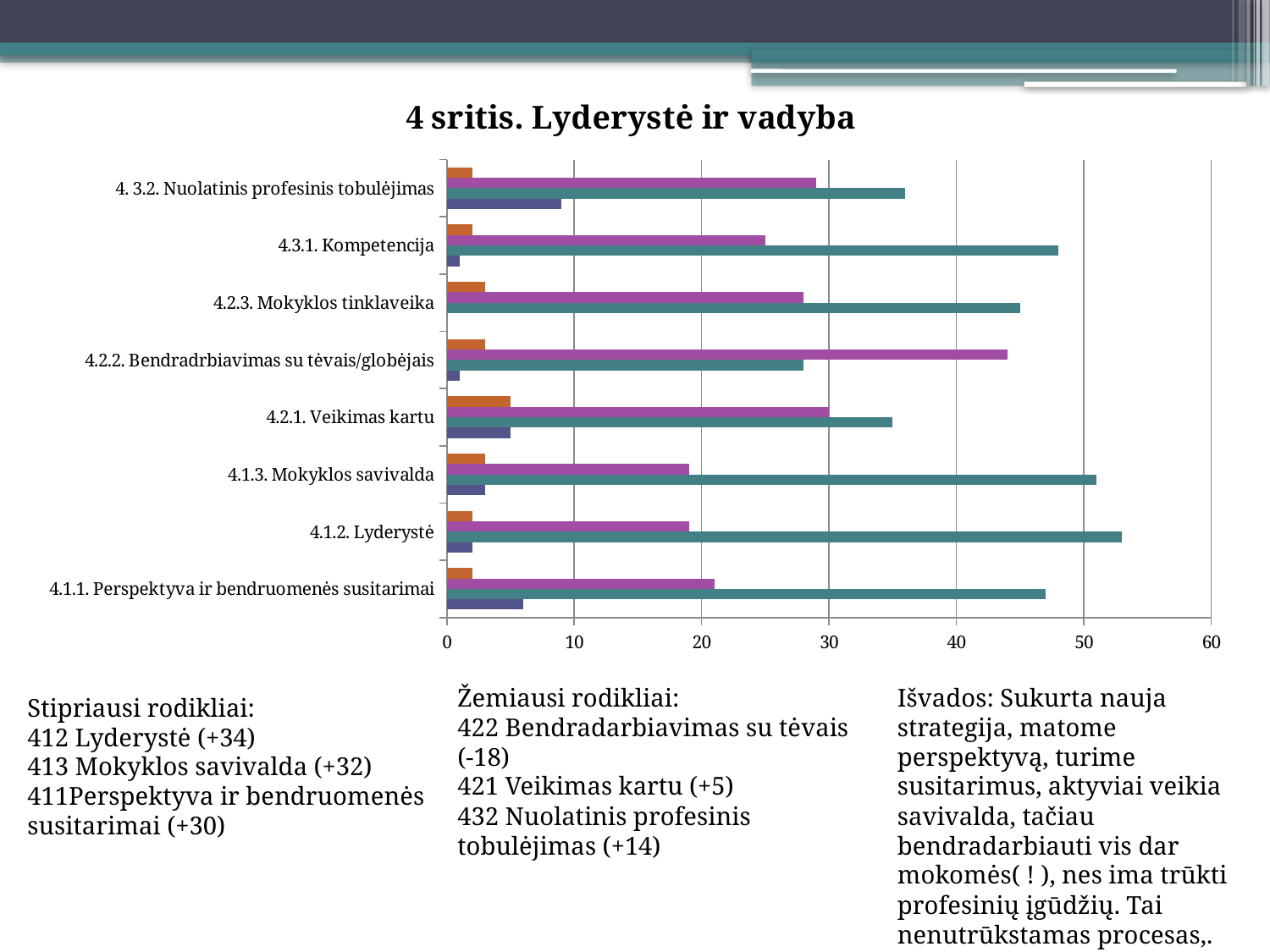
What is the title of the chart? 4 sritis. Lyderystė ir vadyba Is the teal bar for 4.2.3. Mokyklos tinklaveika greater or less than 40? greater Is the teal bar for 4.1.2. Lyderystė greater or less than 50? greater Is the purple bar for 4.2.2. Bendradrbiavimas su tėvais/globėjais greater or less than 40? greater For 4.1.3. Mokyklos savivalda, which is larger: the teal bar or the purple bar? the teal bar How many categories are shown on the chart's vertical axis? 8 What kind of chart is shown on the slide? bar chart Which category has the shortest teal bar? 4.2.2. Bendradrbiavimas su tėvais/globėjais For 4.2.2. Bendradrbiavimas su tėvais/globėjais, which is larger: the purple bar or the teal bar? the purple bar